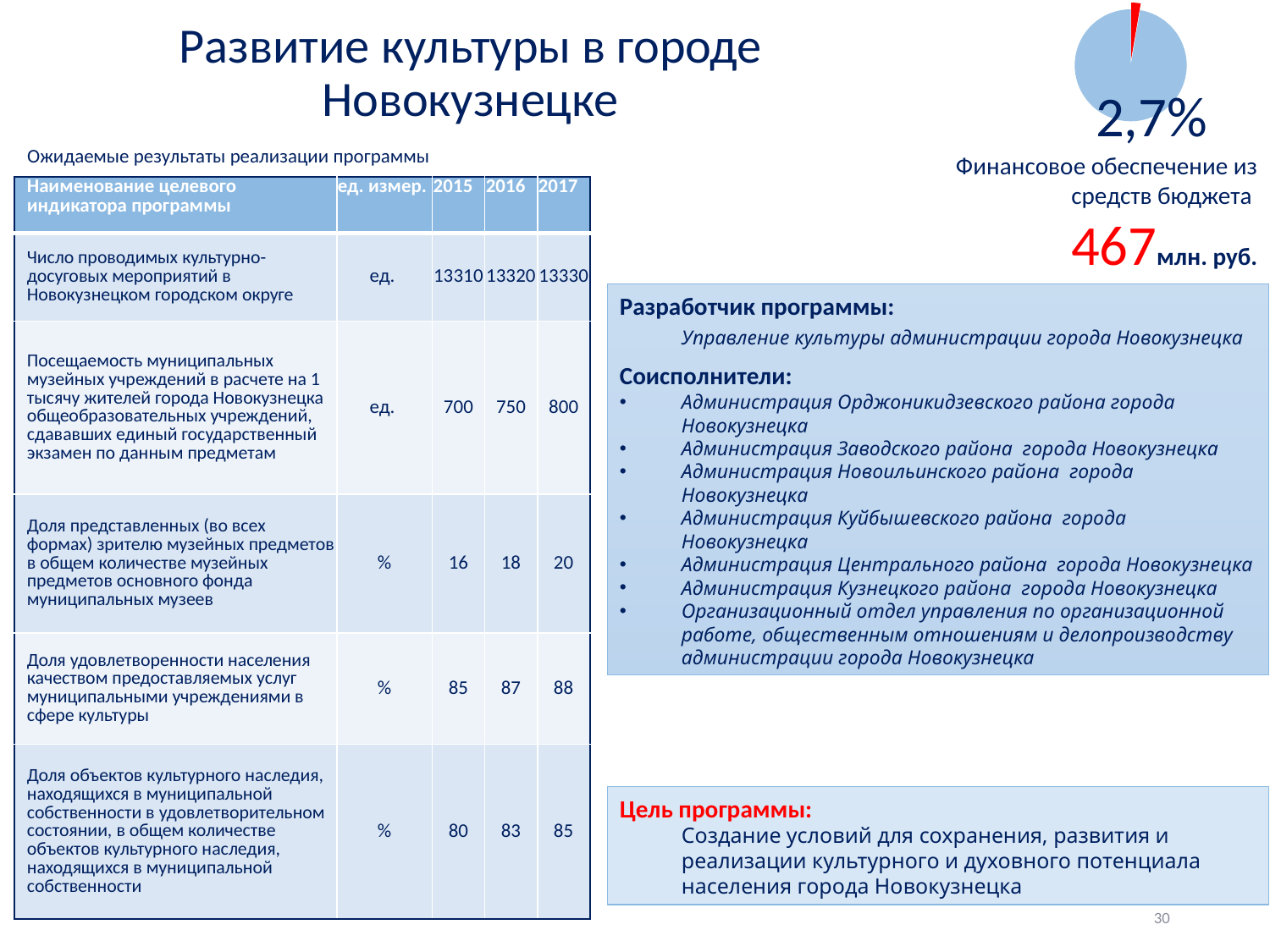
What does the pie chart illustrate, according to the caption below it? Финансовое обеспечение из средств бюджета What share of the pie does the red slice represent? 2,7% How many slices does the pie chart have? 2 What kind of chart is shown in the top right corner of the slide? pie chart What colour is the slice labelled 2,7% in the pie chart? red Which slice of the pie chart is the smallest? the red slice (2,7%) Which slice of the pie chart is larger, the blue one or the red one? the blue one What percentage is printed next to the red slice of the pie chart? 2,7%